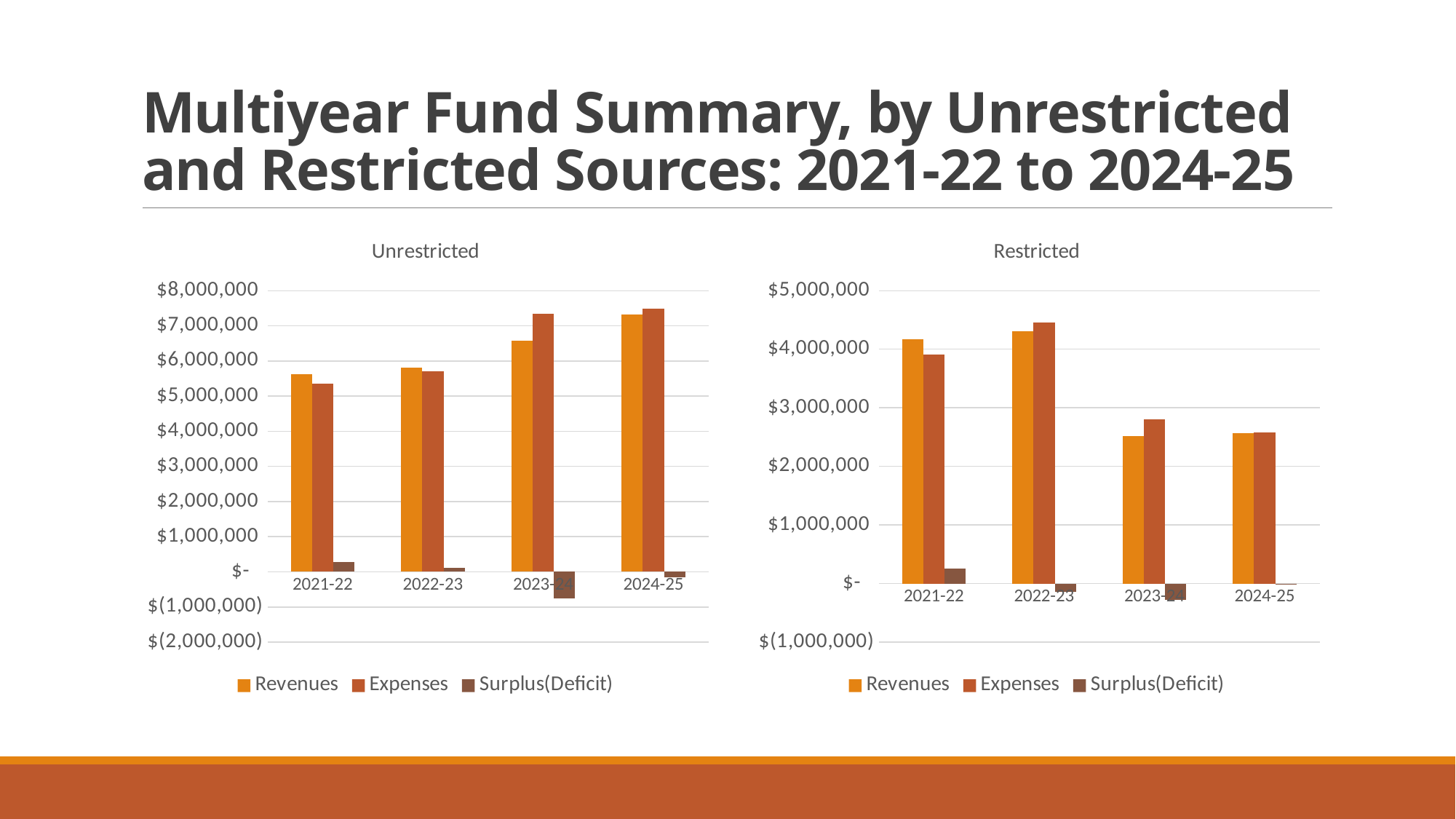
In the Unrestricted chart, is the Expenses value for 2023-24 greater or less than $7,000,000? greater How many series does the legend of the Restricted chart list? 3 In the Unrestricted chart, do Revenues rise or fall from 2021-22 to 2024-25? Rise In the Restricted chart, is the Revenues value for 2023-24 greater or less than $3,000,000? less In the Unrestricted chart, is the Revenues value for 2021-22 greater or less than $5,000,000? greater In the Unrestricted chart, which is larger for 2023-24, Revenues or Expenses? Expenses What kind of chart is the Unrestricted chart? Bar chart How many fiscal years are shown on the x axis of the Unrestricted chart? 4 In the Restricted chart, which is larger for 2021-22, Revenues or Expenses? Revenues What is the highest value labelled on the y axis of the Restricted chart? $5,000,000 In the Restricted chart, which year has the highest Expenses? 2022-23 In the Unrestricted chart, which year has the highest Revenues? 2024-25